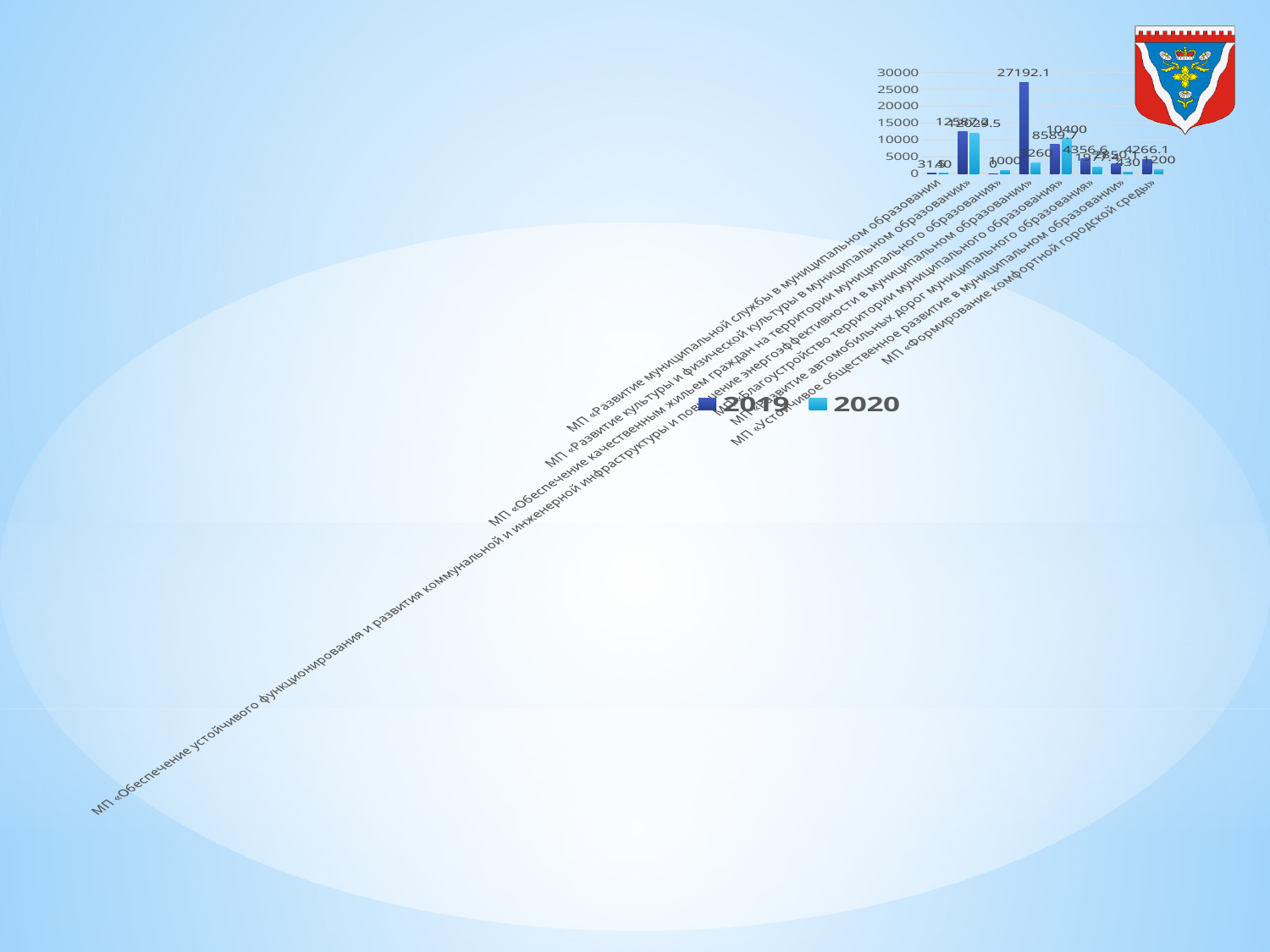
What is the 2019 value for МП «Формирование комфортной городской среды»? 4266.1 What are the two series named in the chart legend? 2019 and 2020 How many series does the chart legend list? 2 What is the difference between the 2019 and 2020 values for МП «Формирование комфортной городской среды»? 3066.1 Which series contains the tallest bar on the chart? 2019 How many municipal programme categories are plotted on the chart? 8 For МП «Формирование комфортной городской среды», which year has the larger value, 2019 or 2020? 2019 What is the highest value labelled on the chart? 27192.1 Is the tallest bar on the chart greater or less than 25000? greater What is the 2020 value for МП «Формирование комфортной городской среды»? 1200 What kind of chart is shown on the slide? bar chart For МП «Благоустройство территории муниципального образования», which year has the larger value, 2019 or 2020? 2020